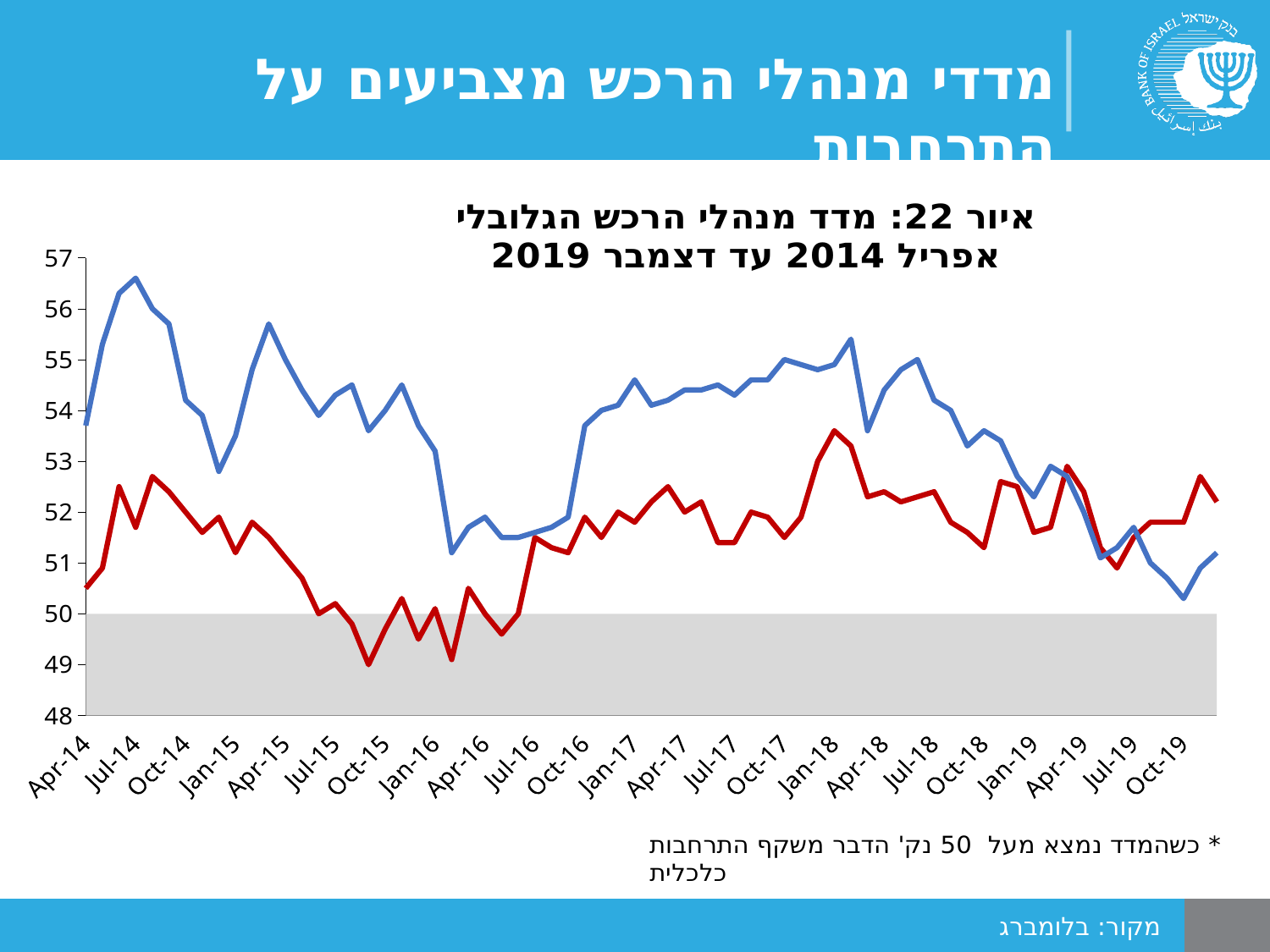
Is the value of the red line at Oct-15 greater or less than 50? less How many lines are plotted on the chart? 2 How many date labels are shown on the x axis? 23 At Apr-14, which line has the higher value, the blue line or the red line? the blue line At Oct-19, which line has the higher value, the blue line or the red line? the red line What kind of chart is shown on the slide? line chart Does the blue line rise or fall between Apr-14 and Jul-14? rise Is the value of the blue line at Oct-19 greater or less than 51? less Is the value of the blue line at Jul-14 greater or less than 56? greater Does the red line rise or fall between Jul-15 and Oct-15? fall What is the highest value shown on the y axis? 57